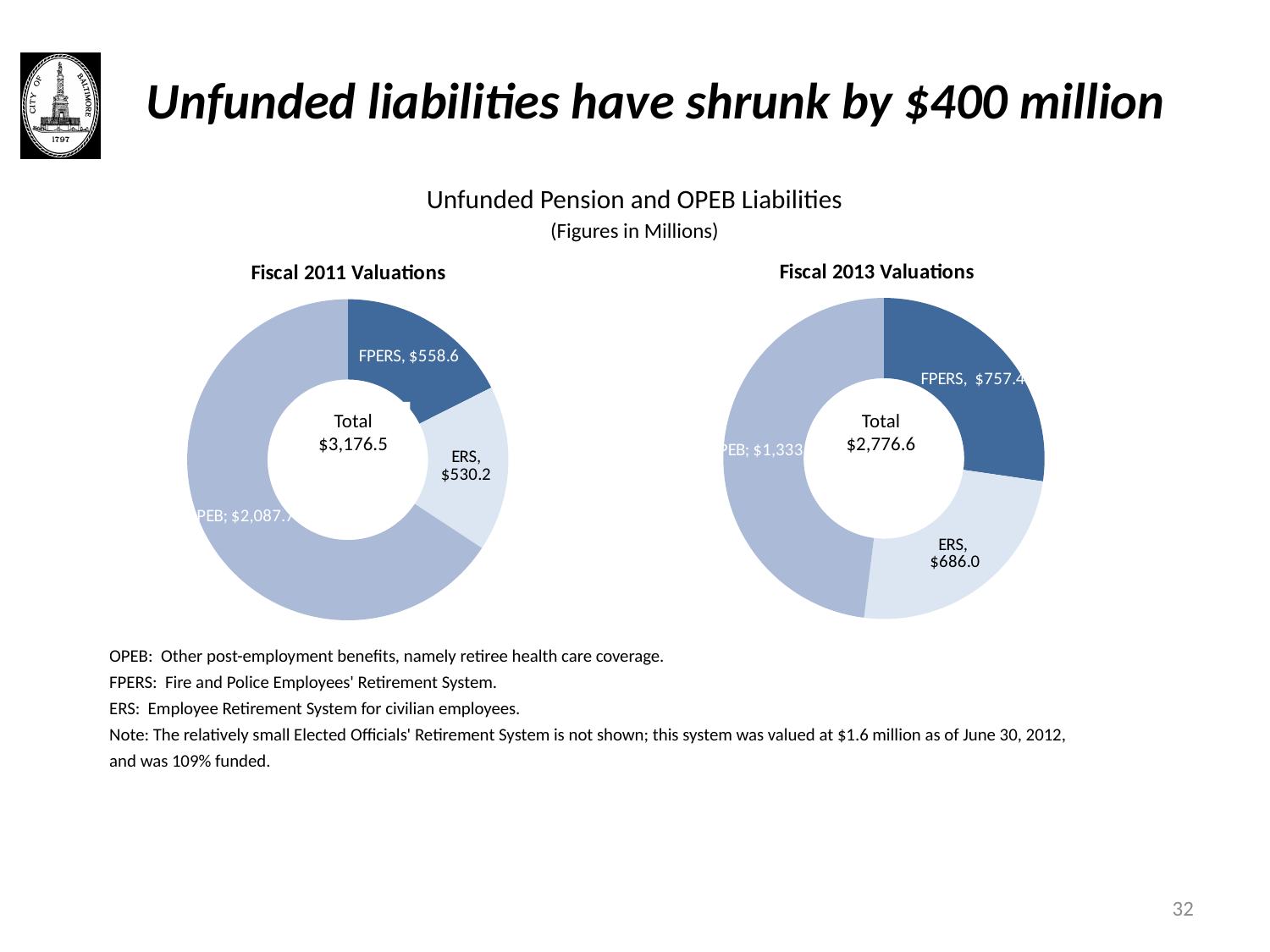
In the Fiscal 2011 Valuations chart, what is the value for ERS? $530.2 In the Fiscal 2011 Valuations chart, which category has the largest slice? OPEB In the Fiscal 2013 Valuations chart, what total is shown in the centre of the donut? $2,776.6 How many categories are shown in the Fiscal 2011 Valuations chart? 3 By how much did the FPERS value increase from the Fiscal 2011 chart to the Fiscal 2013 chart? $198.8 In the Fiscal 2013 Valuations chart, what is the value for FPERS? $757.4 In the Fiscal 2013 Valuations chart, which is larger, FPERS or ERS? FPERS In the Fiscal 2013 Valuations chart, what is the value for ERS? $686.0 What is the difference between the total in the Fiscal 2011 chart and the total in the Fiscal 2013 chart? $399.9 In the Fiscal 2011 Valuations chart, what total is shown in the centre of the donut? $3,176.5 In the Fiscal 2011 Valuations chart, what is the value for FPERS? $558.6 What kind of chart is used for the Fiscal 2013 Valuations? Pie (donut) chart